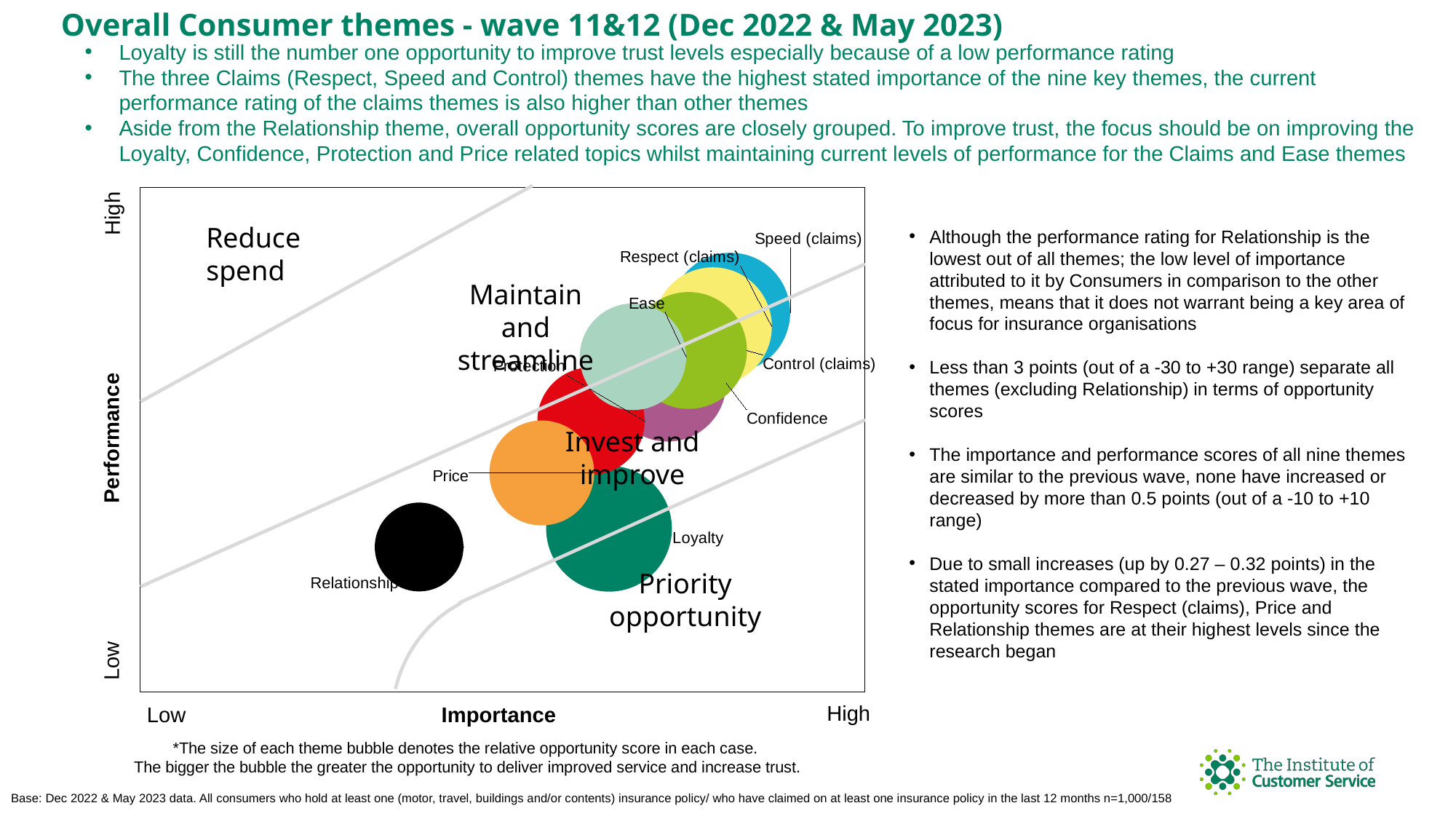
What is the label of the horizontal axis of the chart? Importance Which quadrant label is the Loyalty bubble positioned in? Priority opportunity Which theme has higher importance, Loyalty or Relationship? Loyalty How many theme bubbles are plotted on the chart? 9 According to the note below the chart, what does the size of each bubble denote? The relative opportunity score Which theme has the lowest performance rating on the chart? Relationship Which theme has higher performance, Speed (claims) or Price? Speed (claims) Which theme has higher performance, Ease or Loyalty? Ease Which theme has the largest bubble on the chart? Loyalty What kind of chart is shown on the slide? Bubble chart Which theme has the lowest importance on the chart? Relationship